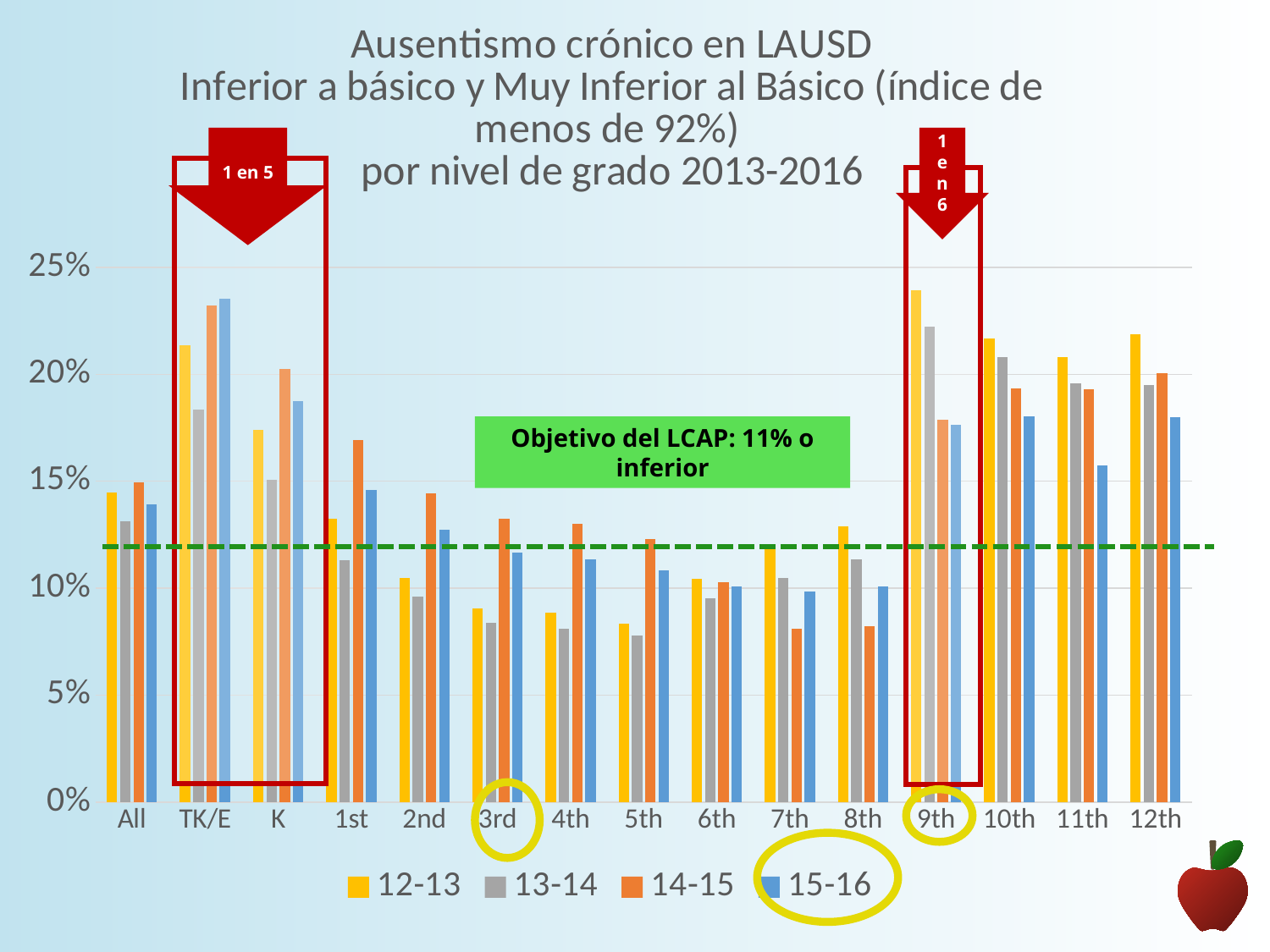
Is the 15-16 value for TK/E greater or less than 20%? greater What kind of chart is shown on the slide? bar chart What target does the green box state for the LCAP? 11% o inferior Which series does the legend list? 12-13, 13-14, 14-15, 15-16 How many grade-level categories are shown on the x axis? 15 Is the 12-13 value for 9th grade greater or less than 20%? greater Is the 13-14 value for 5th grade greater or less than 10%? less Which grade level has the highest 15-16 value? TK/E For 9th grade, which is larger: the 12-13 value or the 15-16 value? 12-13 How many series does the legend list? 4 Do the 12-13 values rise or fall from 1st grade to 5th grade? fall